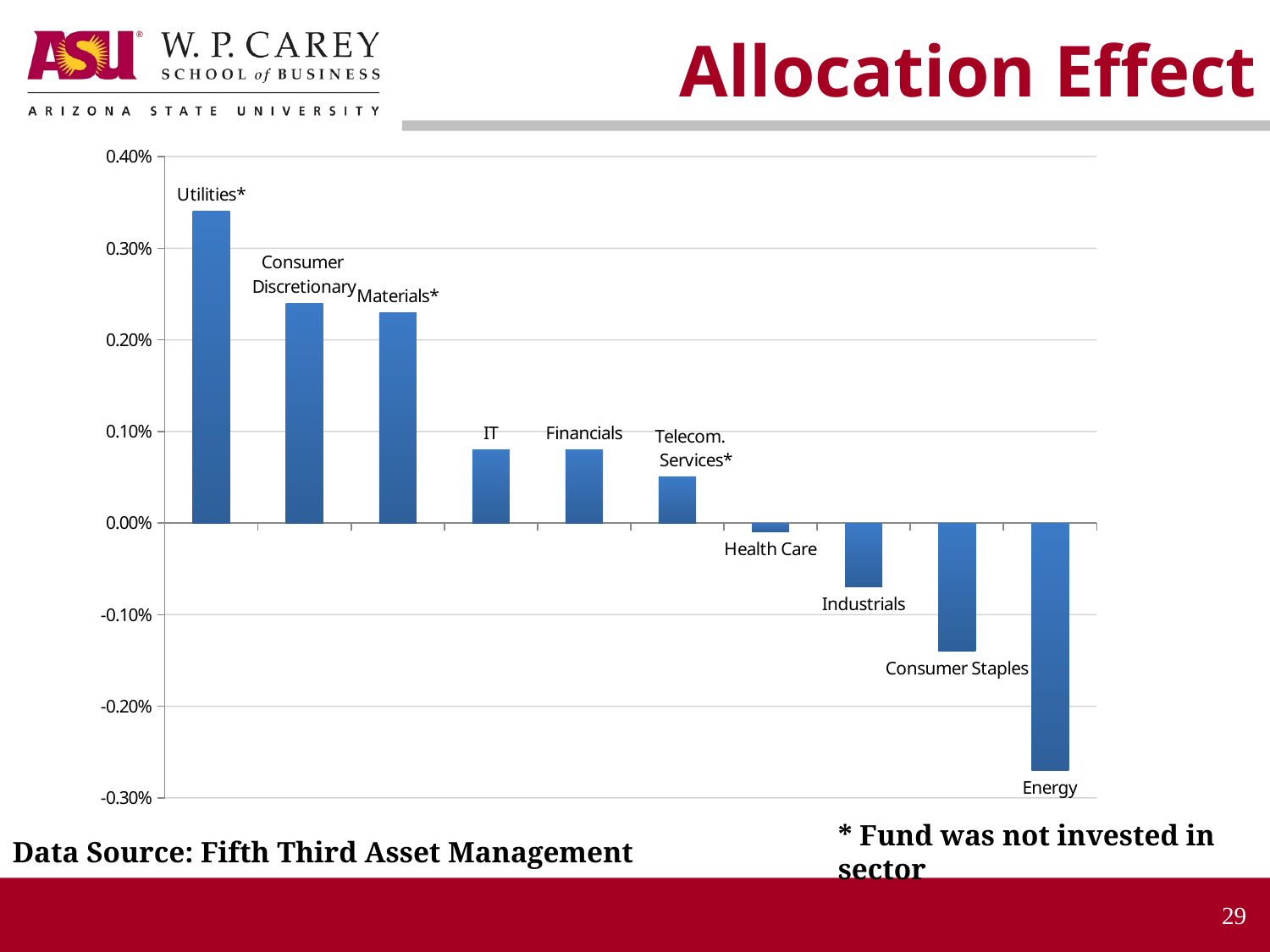
Which is larger, the value for Utilities* or the value for Consumer Discretionary? Utilities* Which is larger, the value for Industrials or the value for Consumer Staples? Industrials Is the value for IT greater or less than 0.10%? less What kind of chart is shown on the slide? bar chart What is the title of the chart? Allocation Effect Is the value for Consumer Staples greater or less than -0.10%? less Do the values rise or fall moving from left to right along the x axis? fall Is the value for Utilities* greater or less than 0.30%? greater Which sector has the lowest allocation effect? Energy How many sectors are plotted in the chart? 10 Which sector has the highest allocation effect? Utilities*